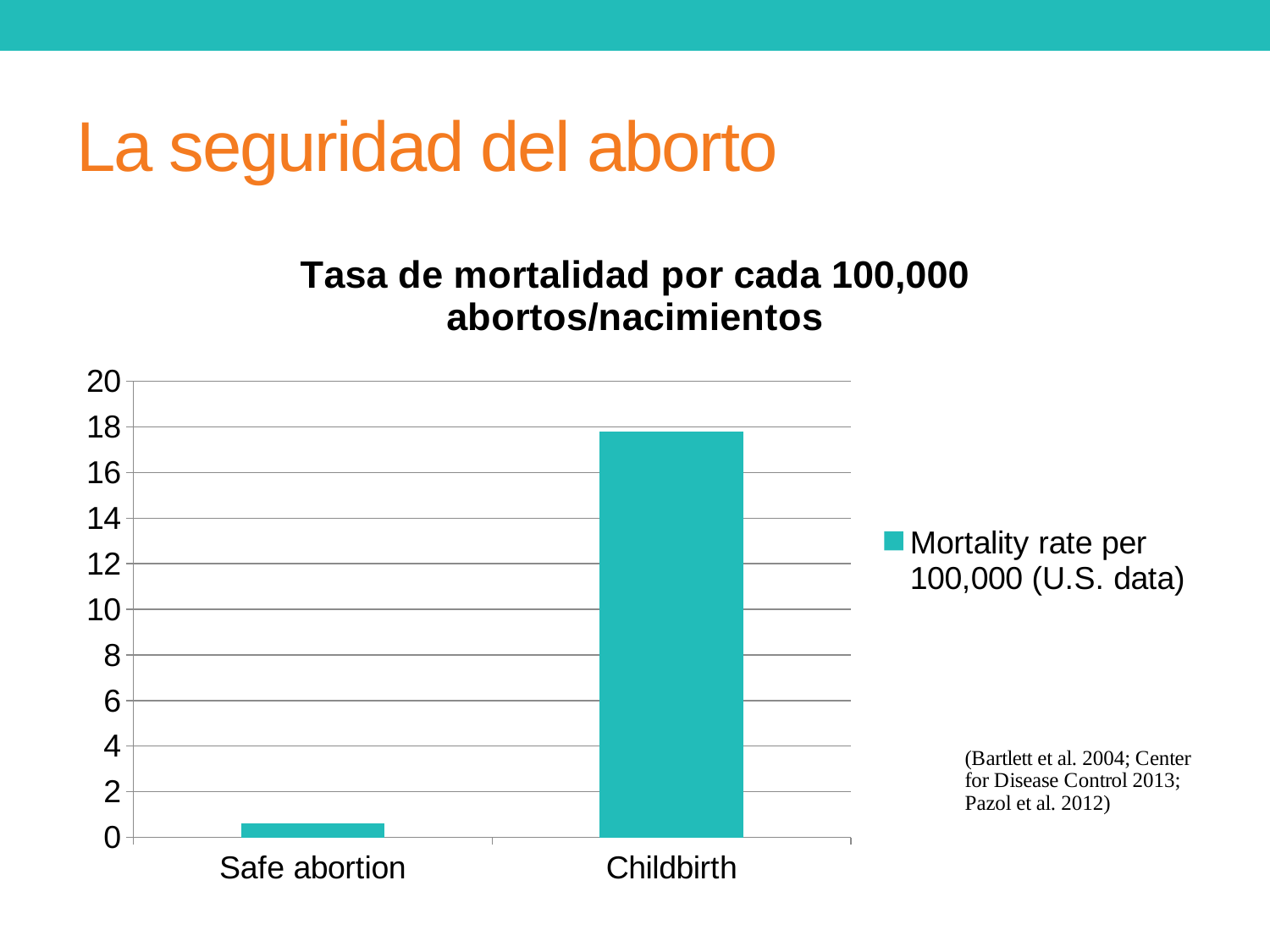
What series name is shown in the chart's legend? Mortality rate per 100,000 (U.S. data) Is the value for Safe abortion greater or less than 2? less What is the highest value shown on the chart's y axis? 20 Which category has the lowest mortality rate in the chart? Safe abortion What is the title of the chart? Tasa de mortalidad por cada 100,000 abortos/nacimientos Is the value for Childbirth greater or less than 16? greater Which category has the highest mortality rate in the chart? Childbirth How many series does the chart's legend list? 1 How many categories are shown on the x axis of the chart? 2 Which has a larger value in the chart, Safe abortion or Childbirth? Childbirth What kind of chart is shown on the slide? bar chart